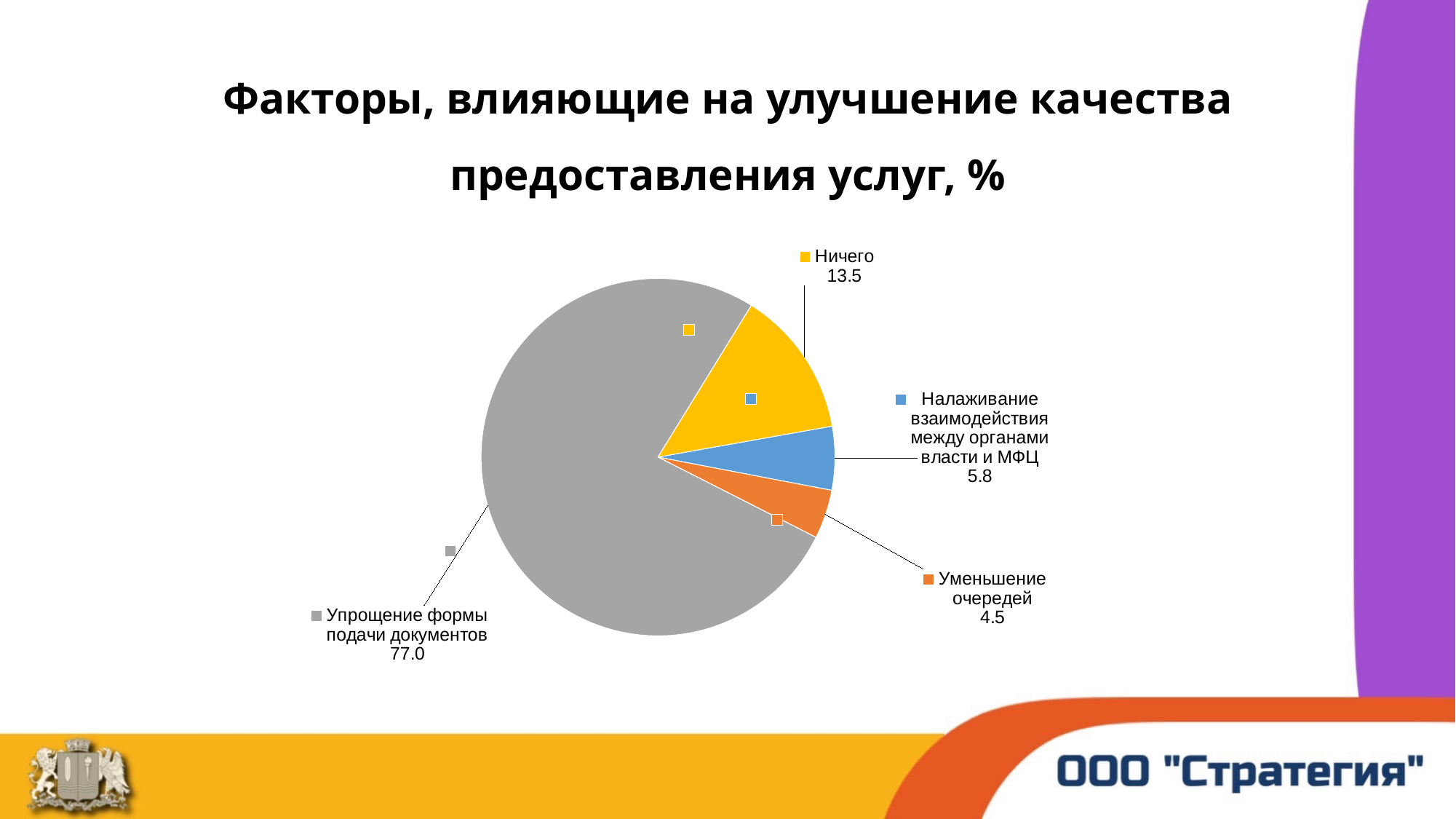
What is the value for "Налаживание взаимодействия между органами власти и МФЦ"? 5.8 What kind of chart is shown on the slide? pie chart What is the value for "Уменьшение очередей"? 4.5 What is the title of the chart on the slide? Факторы, влияющие на улучшение качества предоставления услуг, % Which category has the smallest slice of the pie? Уменьшение очередей Which is larger: the value for "Ничего" or the value for "Налаживание взаимодействия между органами власти и МФЦ"? Ничего What is the difference between the values for "Налаживание взаимодействия между органами власти и МФЦ" and "Уменьшение очередей"? 1.3 Which category has the largest slice of the pie? Упрощение формы подачи документов What is the value for "Упрощение формы подачи документов"? 77.0 How many slices does the pie chart have? 4 What is the value for "Ничего"? 13.5 What is the difference between the values for "Упрощение формы подачи документов" and "Ничего"? 63.5